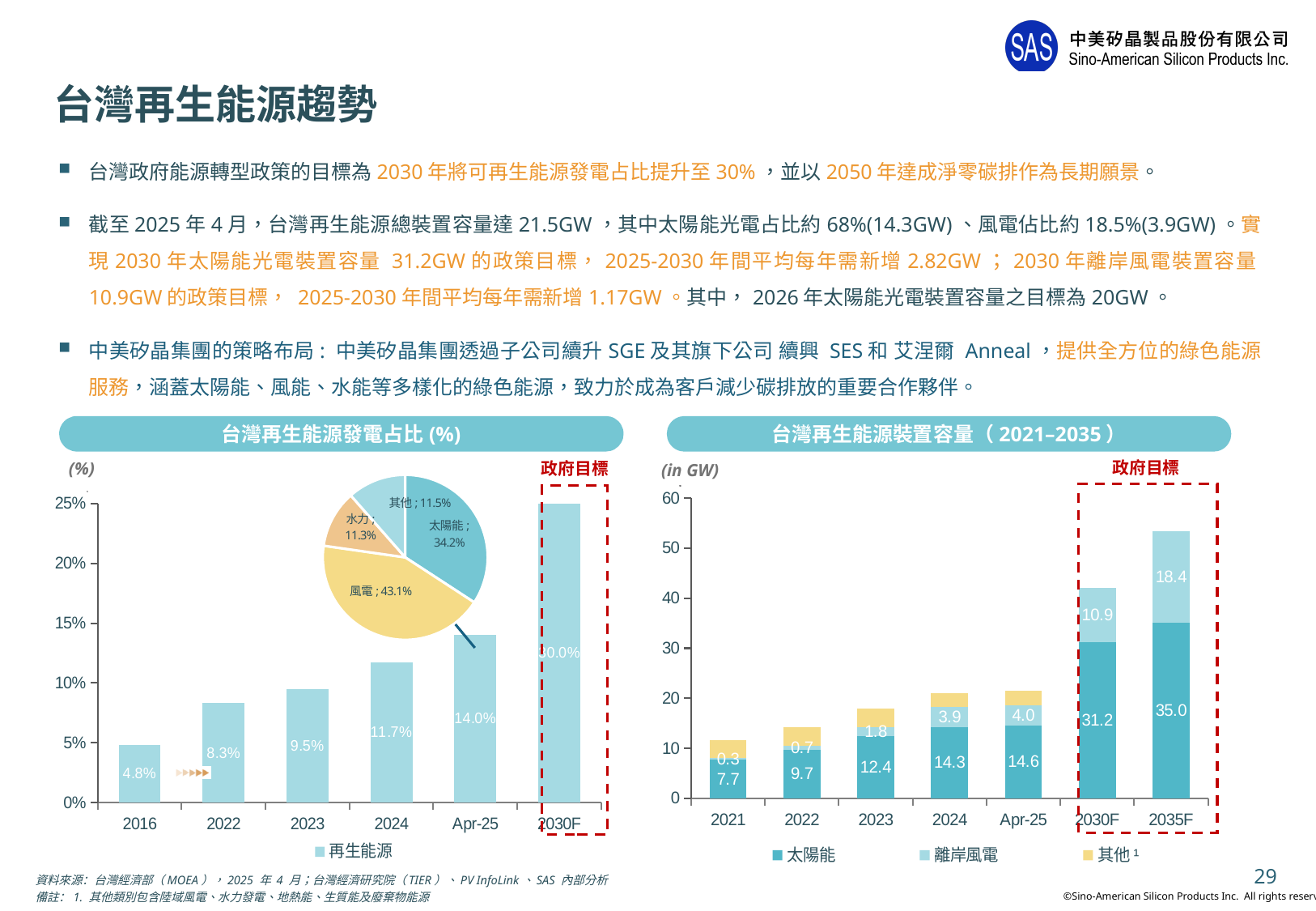
How many series does the legend of the 台灣再生能源裝置容量（2021–2035）chart list? 3 In the 台灣再生能源發電占比 (%) chart, what is the difference between the 2030F value and the Apr-25 value? 16.0% In the 台灣再生能源發電占比 (%) chart, how many bars are plotted? 6 In the 台灣再生能源裝置容量（2021–2035）chart, is the total stacked value for 2035F greater or less than 50? greater In the pie chart inset on the 台灣再生能源發電占比 (%) chart, what share does 風電 have? 43.1% In the 台灣再生能源發電占比 (%) chart, do the values rise or fall from 2016 to 2030F? rise In the 台灣再生能源發電占比 (%) chart, what is the value for 2030F? 30.0% In the 台灣再生能源裝置容量（2021–2035）chart, what is the 離岸風電 value for 2030F? 10.9 What kind of chart is the 台灣再生能源裝置容量（2021–2035）chart? stacked bar chart In the 台灣再生能源發電占比 (%) chart, which year has the lowest value? 2016 In the 台灣再生能源裝置容量（2021–2035）chart, what is the 太陽能 value for 2035F? 35.0 In the 台灣再生能源發電占比 (%) chart, what is the value for 2024? 11.7%